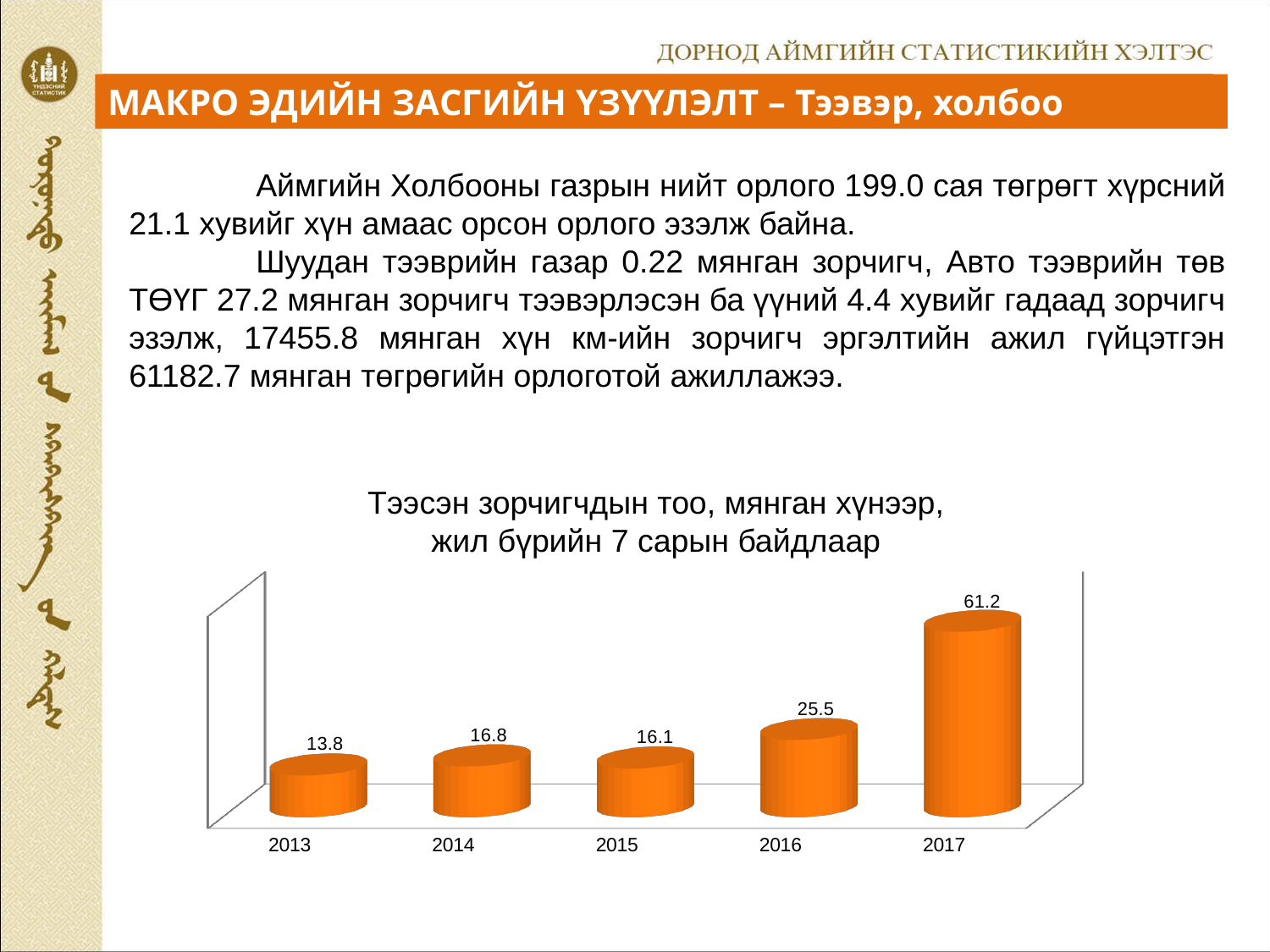
Which year has the lowest value in the chart? 2013 Which year has the highest value in the chart? 2017 What is the value for 2017 in the chart? 61.2 What is the value for 2013 in the chart? 13.8 What type of chart is shown on the slide? bar chart What is the difference between the values for 2017 and 2016? 35.7 What is the value for 2016 in the chart? 25.5 Does the value rise or fall from 2016 to 2017? rise What is the title of the chart? Тээсэн зорчигчдын тоо, мянган хүнээр, жил бүрийн 7 сарын байдлаар Which is larger, the value for 2014 or the value for 2015? 2014 How many years are shown in the chart? 5 What is the difference between the values for 2014 and 2015? 0.7